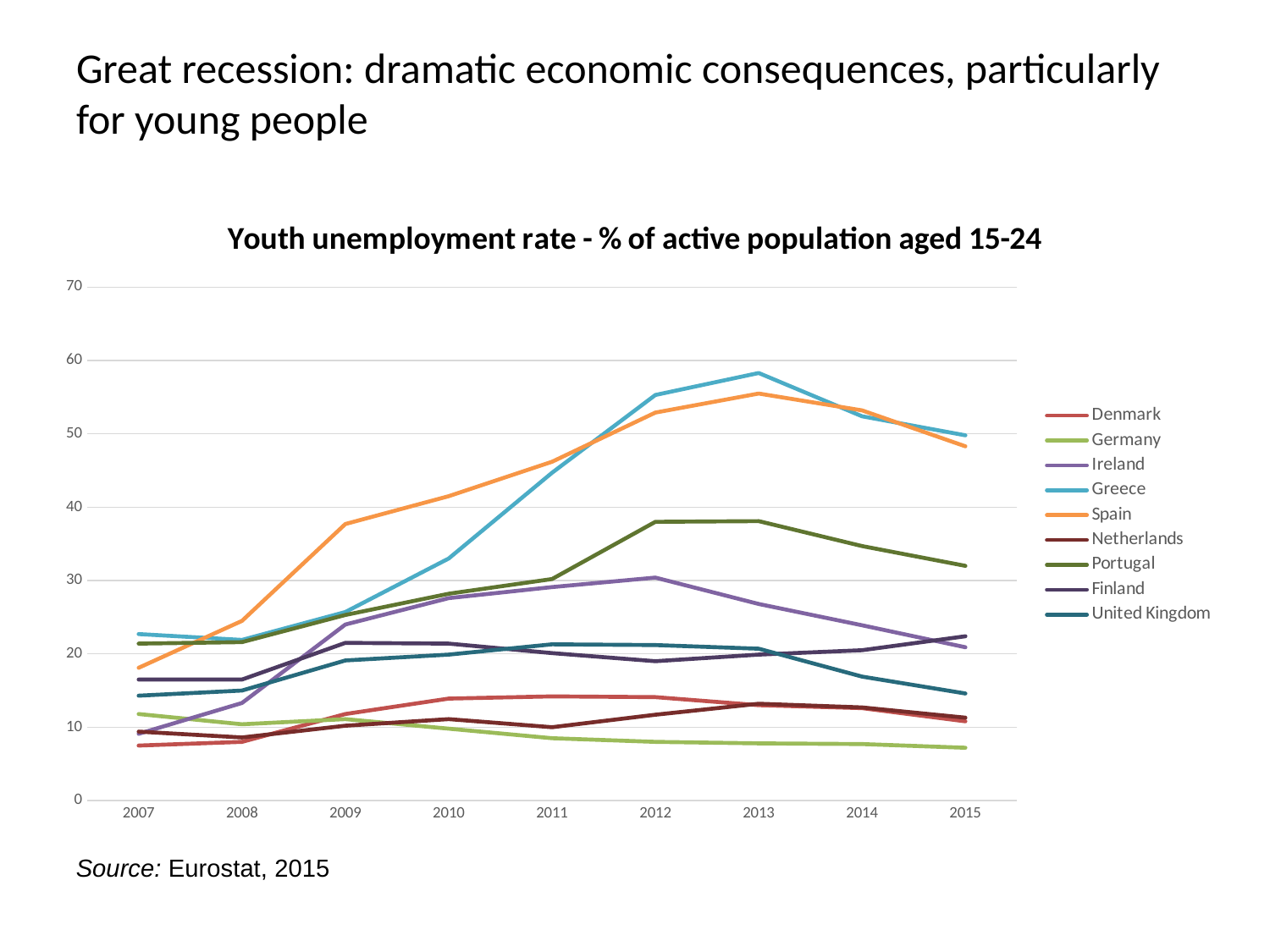
Is the value for Germany in 2015 greater or less than 10? less What kind of chart is shown on the slide? Line chart How many countries are listed in the chart's legend? 9 Does the youth unemployment rate for Spain rise or fall from 2007 to 2013? Rise Which country has the highest youth unemployment rate in 2013? Greece What is the title of the chart? Youth unemployment rate - % of active population aged 15-24 In 2012, which has the higher youth unemployment rate, Portugal or Ireland? Portugal How many years are shown along the x axis of the chart? 9 Is the value for Greece in 2013 greater or less than 50? greater Does the youth unemployment rate for Germany rise or fall from 2007 to 2015? Fall Is the value for Spain in 2009 greater or less than 30? greater Which country has the lowest youth unemployment rate in 2015? Germany